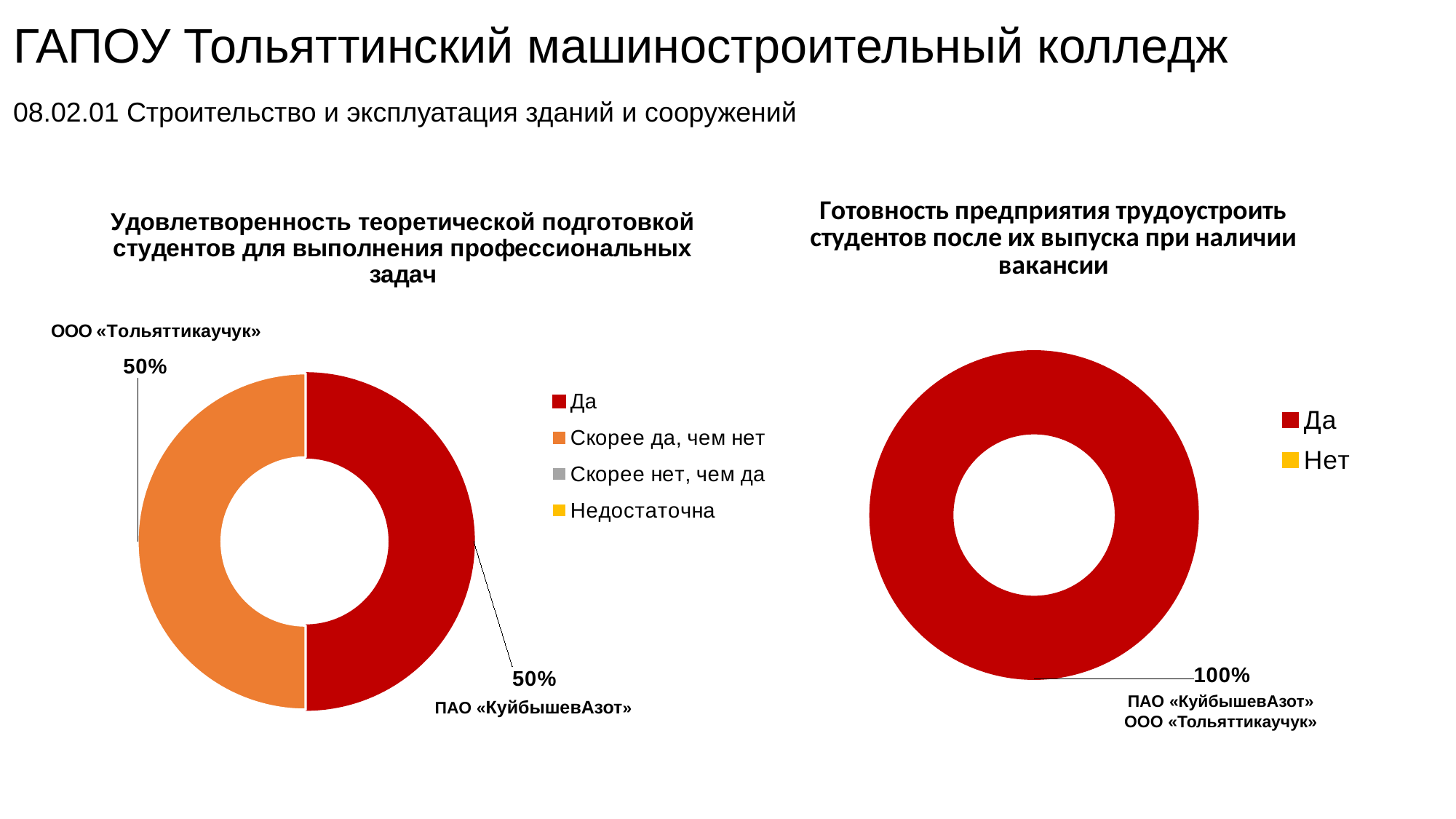
Какого типа левая диаграмма на слайде? Кольцевая (круговая) диаграмма На левой диаграмме какое предприятие дало ответ «Да»? ПАО «КуйбышевАзот» Какого типа правая диаграмма на слайде? Кольцевая (круговая) диаграмма На левой диаграмме какова разница между долями ответов «Да» и «Скорее да, чем нет»? 0% Сколько вариантов ответа перечислено в легенде левой диаграммы? 4 На левой диаграмме какое предприятие дало ответ «Скорее да, чем нет»? ООО «Тольяттикаучук» Сколько диаграмм показано на слайде? 2 На диаграмме «Удовлетворенность теоретической подготовкой студентов для выполнения профессиональных задач» какая доля приходится на ответ «Скорее да, чем нет»? 50% На диаграмме «Удовлетворенность теоретической подготовкой студентов для выполнения профессиональных задач» какая доля приходится на ответ «Да»? 50% На диаграмме «Готовность предприятия трудоустроить студентов после их выпуска при наличии вакансии» какая доля приходится на ответ «Да»? 100% Сколько вариантов ответа перечислено в легенде правой диаграммы? 2 На правой диаграмме какой ответ занимает наибольшую долю? Да